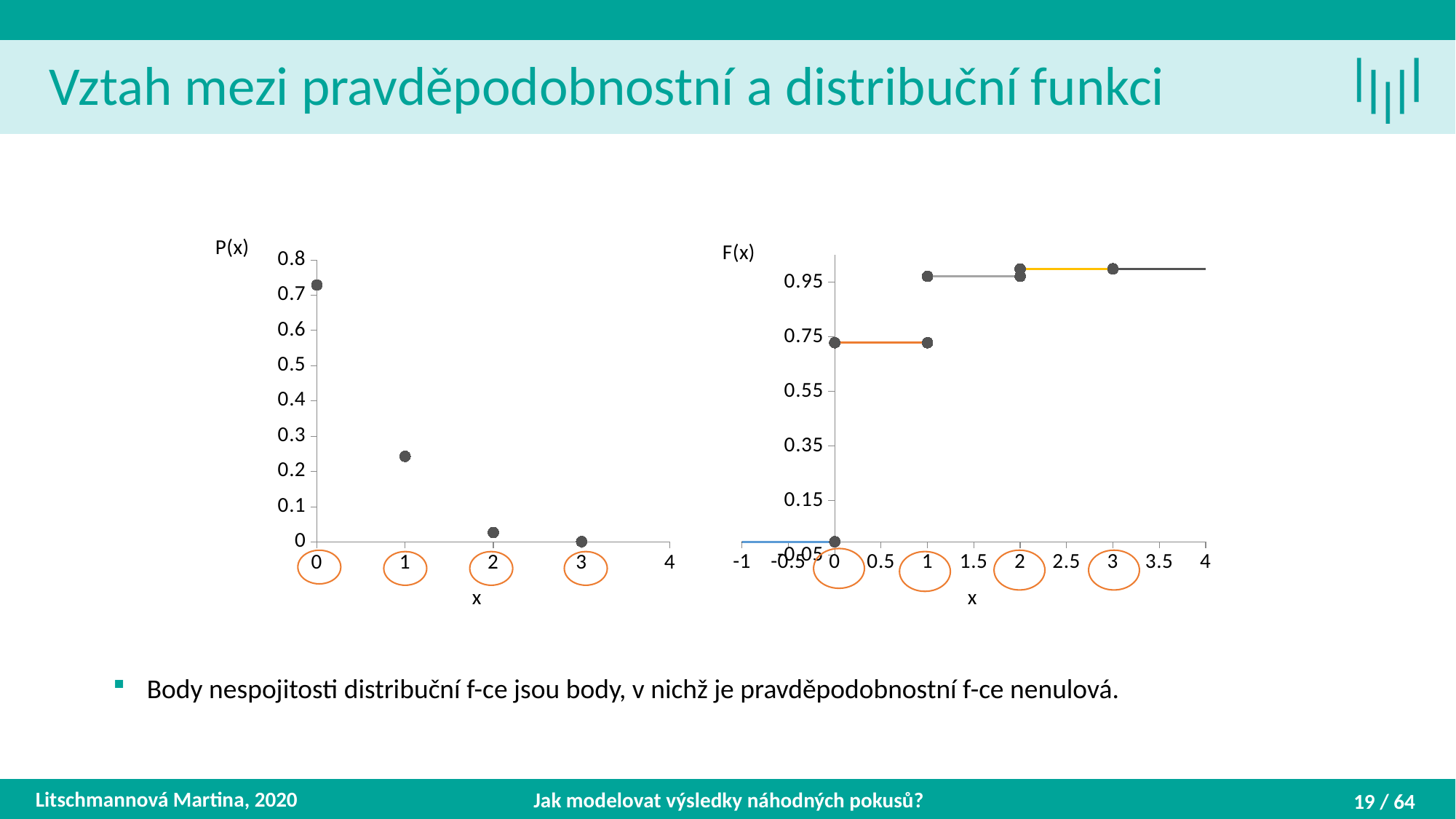
What is the label on the vertical axis of the left chart? P(x) In the left chart (P(x)), do the values rise or fall as x increases? fall In the left chart (P(x)), is the value for x = 0 greater or less than 0.5? greater In the left chart (P(x)), which is larger, the value at x = 0 or the value at x = 1? x = 0 In the left chart (P(x)), is the value for x = 2 greater or less than 0.1? less In the left chart (P(x)), how many data points are plotted? 4 In the left chart (P(x)), which x value has the highest plotted probability? 0 In the left chart (P(x)), is the value for x = 1 greater or less than 0.3? less In the right chart (F(x)), do the values rise or fall as x increases? rise What is the label on the vertical axis of the right chart? F(x)